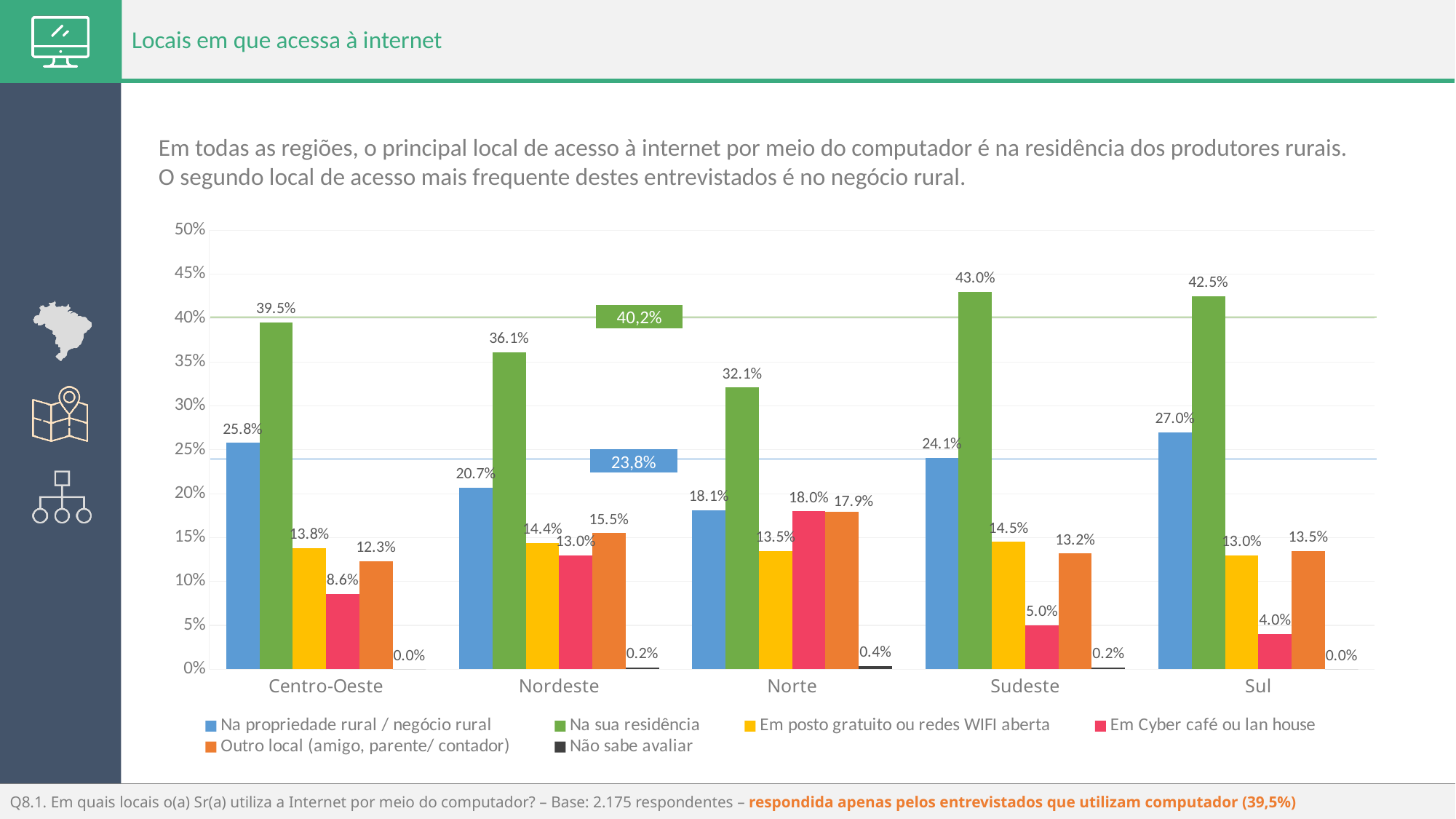
What is the value for 'Na propriedade rural / negócio rural' in Nordeste? 20.7% How many regions are shown on the x axis? 5 Which region has the highest value for 'Na sua residência'? Sudeste What is the difference between 'Na sua residência' and 'Na propriedade rural / negócio rural' in Centro-Oeste? 13.7% What is the value for 'Em Cyber café ou lan house' in Sul? 4.0% Which region has the lowest value for 'Na propriedade rural / negócio rural'? Norte What is the value for 'Na sua residência' in Sudeste? 43.0% Which is larger in Norte: 'Em Cyber café ou lan house' or 'Em posto gratuito ou redes WIFI aberta'? Em Cyber café ou lan house What value is shown in the green reference label on the chart? 40,2% What is the value for 'Não sabe avaliar' in Norte? 0.4% What kind of chart is shown on the slide? bar chart How many series does the legend list? 6